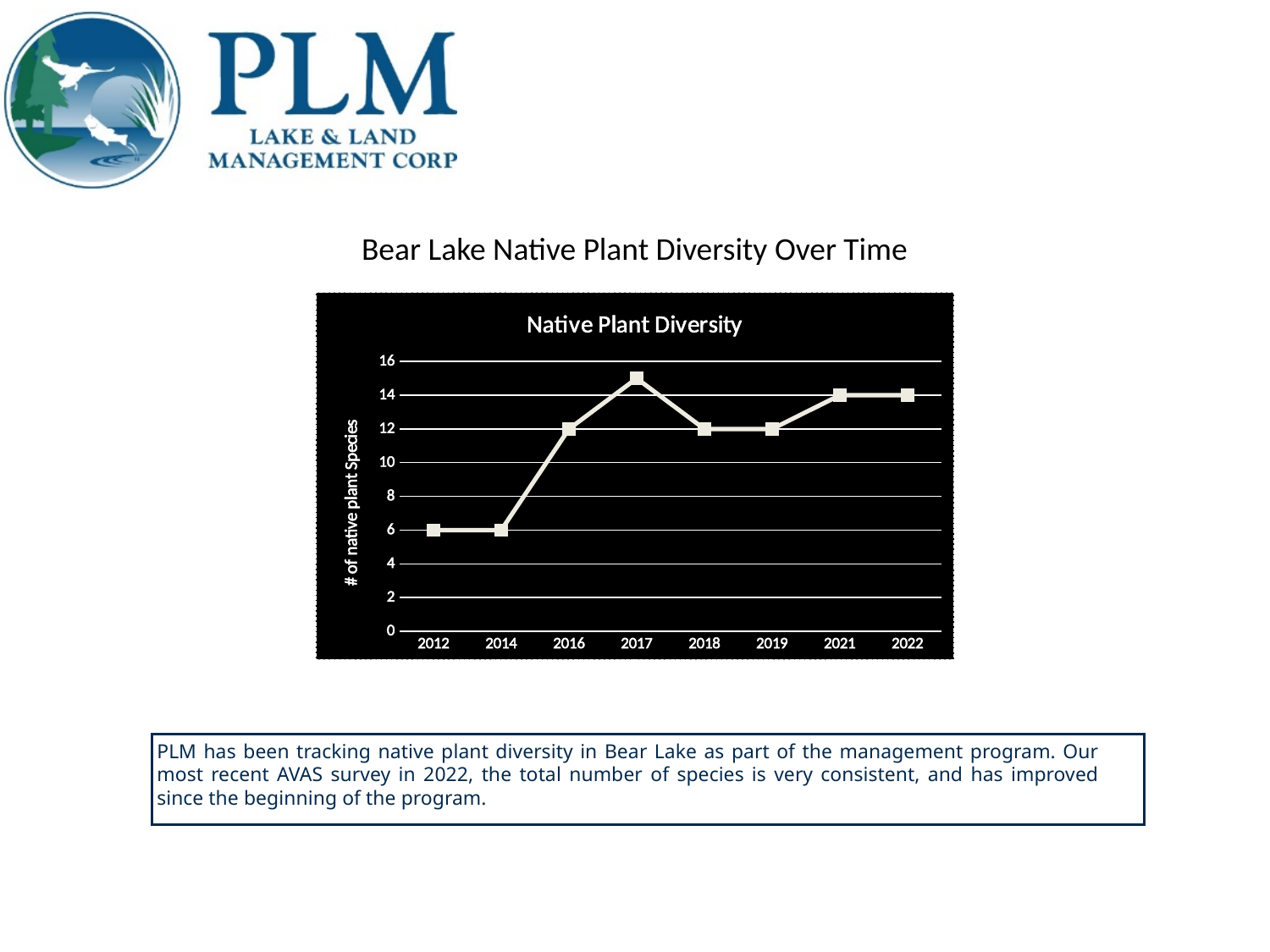
How many data points are plotted on the chart? 8 Is the value for 2017 greater or less than 14? greater What is the label on the vertical axis of the chart? # of native plant Species Which year has the highest number of native plant species? 2017 What is the number of native plant species in 2022? 14 What kind of chart is shown on the slide? line chart What is the number of native plant species in 2016? 12 What is the number of native plant species in 2012? 6 What is the difference between the number of native plant species in 2022 and in 2012? 8 What is the title of the chart? Native Plant Diversity Overall, do the values rise or fall from 2012 to 2022? rise Which year has the larger value, 2016 or 2021? 2021